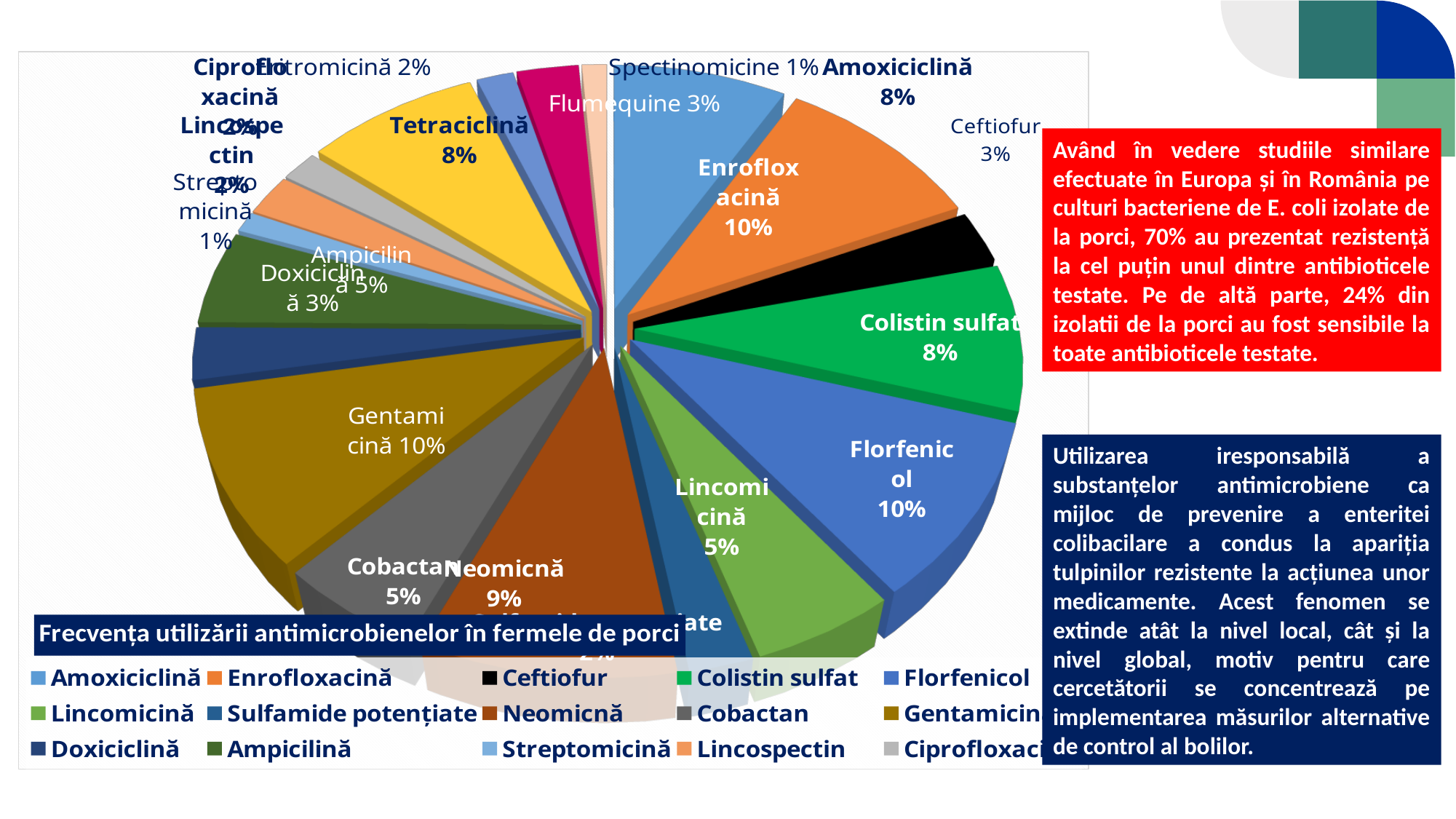
What kind of chart is shown on the slide? pie chart What is the value shown for Ceftiofur? 3% What is the value shown for Neomicnă? 9% What share of the pie does Enrofloxacină represent? 10% Which is larger, the share for Colistin sulfat or the share for Lincomicină? Colistin sulfat What is the difference between the share for Gentamicină and the share for Cobactan? 5% What is the title of the chart? Frecvența utilizării antimicrobienelor în fermele de porci What is the value shown for Spectinomicine? 1% What share of the pie does Tetraciclină represent? 8% What is the value shown for Cobactan? 5% Which is larger, the share for Enrofloxacină or the share for Amoxiciclină? Enrofloxacină What is the value shown for Flumequine? 3%